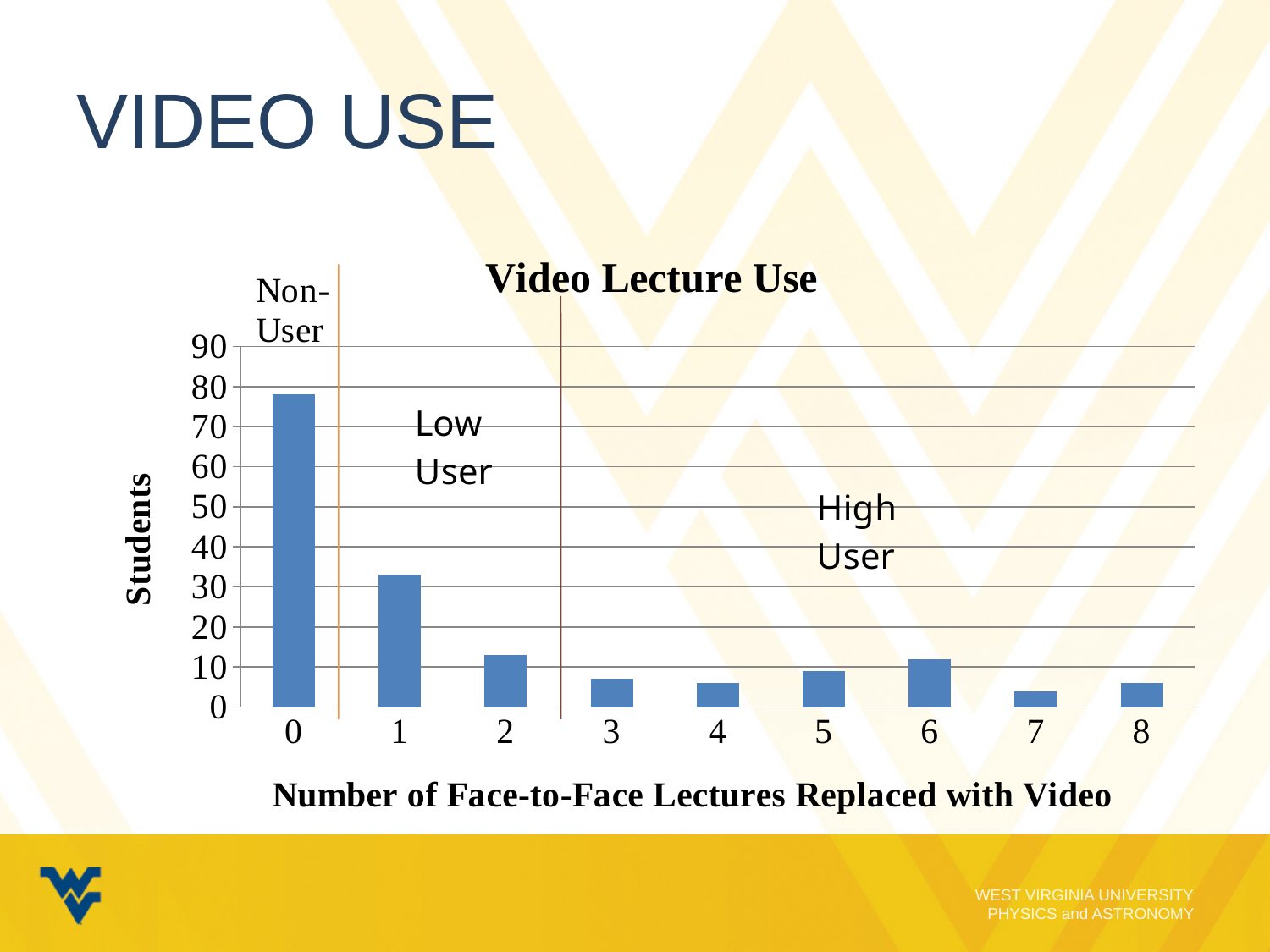
Is the number of students for 0 lectures replaced greater or less than 70? greater Which number of lectures replaced with video has the lowest number of students? 7 Which has more students: 1 lecture replaced or 2 lectures replaced? 1 Is the number of students for 6 lectures replaced greater or less than 10? greater Is the number of students for 3 lectures replaced greater or less than 10? less Which number of lectures replaced with video has the highest number of students? 0 How many categories are shown along the x axis of the chart? 9 What is the title of the chart? Video Lecture Use What kind of chart is shown on the slide? bar chart Do the number of students rise or fall as the number of lectures replaced goes from 0 to 3? fall What is the label on the vertical axis of the chart? Students